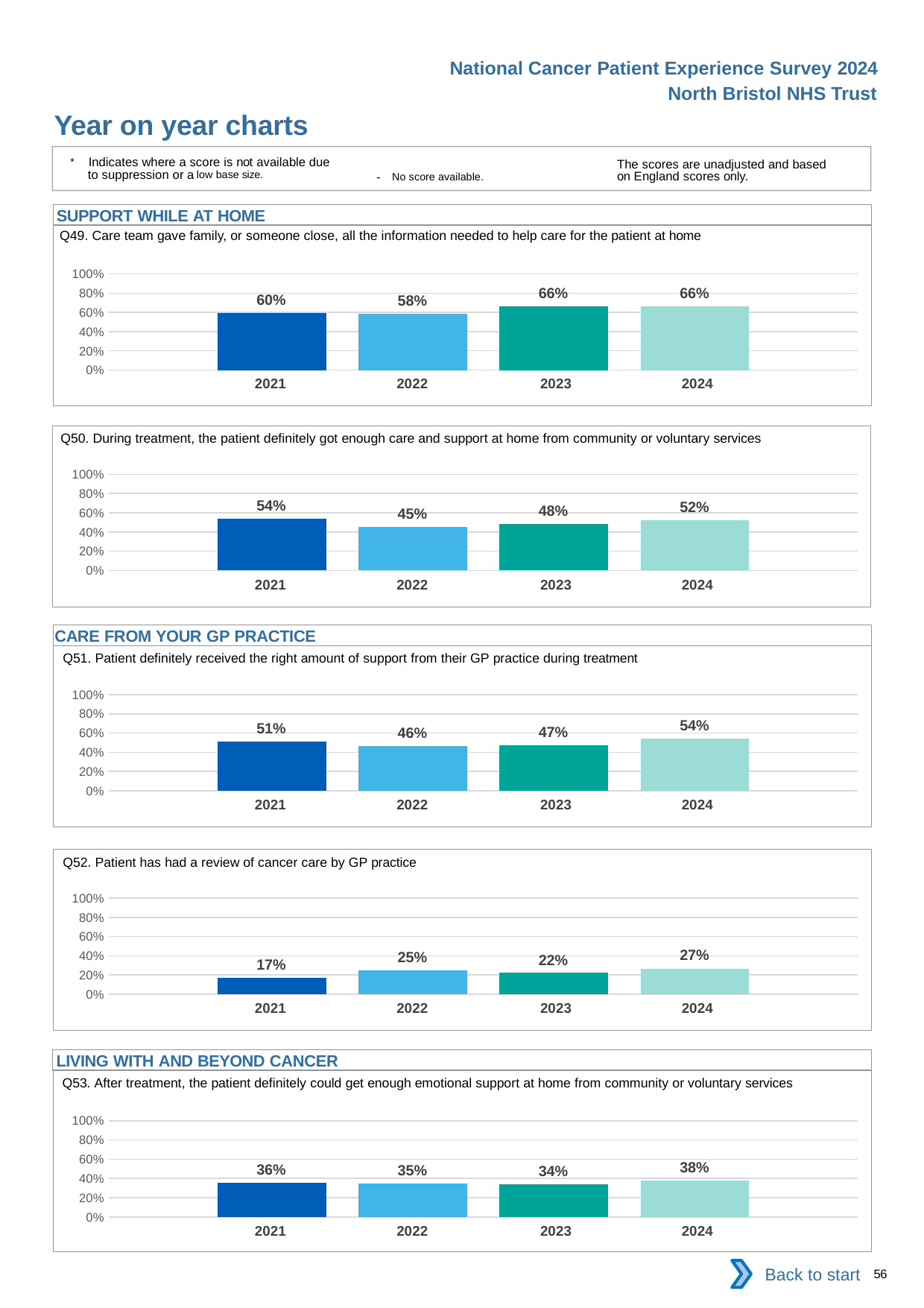
In the Q50 chart, which year has the lowest value? 2022 In the Q49 chart, is the value for 2021 greater or less than 80%? less In the Q51 chart, what is the value for 2023? 47% In the Q51 chart, which year has the highest value? 2024 In the Q50 chart, what is the difference between the 2021 and 2022 values? 9 percentage points In the Q49 chart, what is the value for 2022? 58% What type of chart is used for Q52? bar chart In the Q52 chart, what is the difference between the 2024 and 2021 values? 10 percentage points How many years are shown in the Q49 chart? 4 In the Q53 chart, is the value for 2022 larger or smaller than the value for 2024? smaller In the Q53 chart, what is the value for 2023? 34% In the Q52 chart, which year has the lowest value? 2021